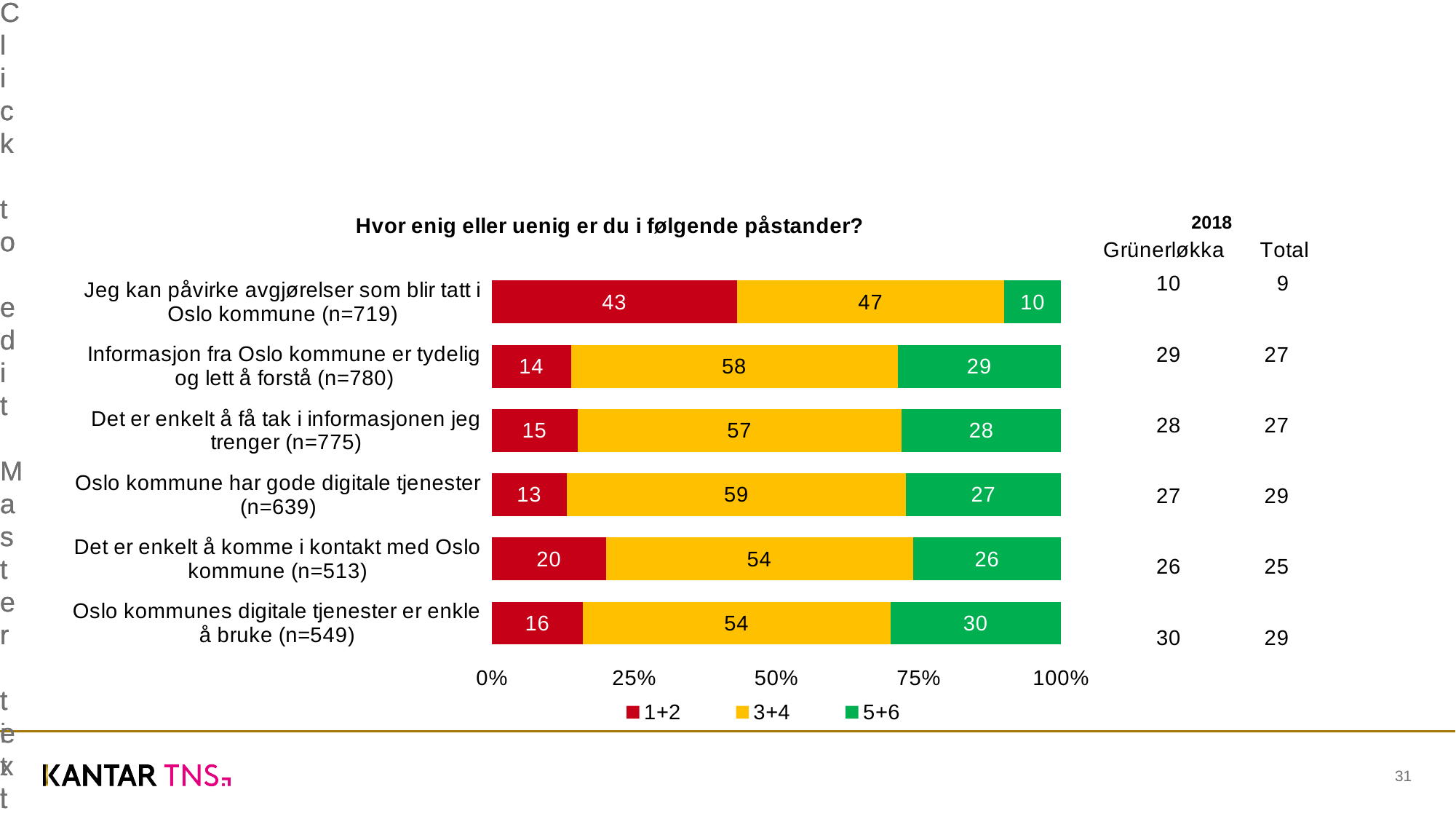
How many series does the legend list? 3 Which category has the lowest value for the 5+6 series? Jeg kan påvirke avgjørelser som blir tatt i Oslo kommune (n=719) What is the value of the 3+4 series for "Oslo kommune har gode digitale tjenester (n=639)"? 59 Which category has the highest value for the 1+2 series? Jeg kan påvirke avgjørelser som blir tatt i Oslo kommune (n=719) How many categories (statements) are shown in the chart? 6 What is the value of the 1+2 series for "Jeg kan påvirke avgjørelser som blir tatt i Oslo kommune (n=719)"? 43 What kind of chart is shown on the slide? Stacked bar chart What is the title of the chart? Hvor enig eller uenig er du i følgende påstander? Is the 1+2 value for "Jeg kan påvirke avgjørelser som blir tatt i Oslo kommune (n=719)" greater or less than 25%? greater Which is larger: the 5+6 value for "Det er enkelt å komme i kontakt med Oslo kommune (n=513)" or the 5+6 value for "Det er enkelt å få tak i informasjonen jeg trenger (n=775)"? Det er enkelt å få tak i informasjonen jeg trenger (n=775) What is the value of the 5+6 series for "Oslo kommunes digitale tjenester er enkle å bruke (n=549)"? 30 What is the difference between the 3+4 value and the 1+2 value for "Informasjon fra Oslo kommune er tydelig og lett å forstå (n=780)"? 44